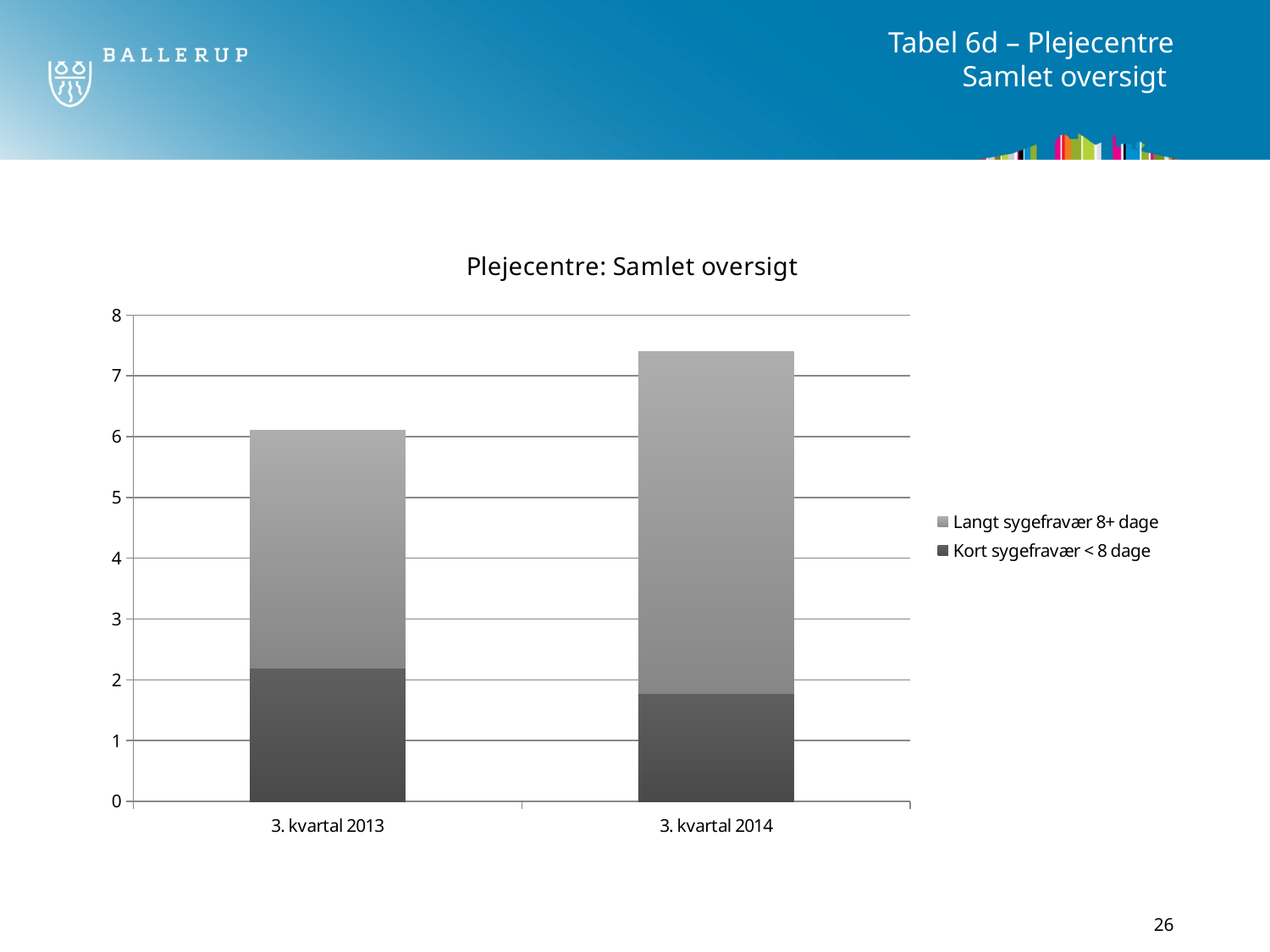
Which quarter has the larger Kort sygefravær < 8 dage segment, 3. kvartal 2013 or 3. kvartal 2014? 3. kvartal 2013 What is the title of the chart? Plejecentre: Samlet oversigt Which quarter has the taller stacked bar in total, 3. kvartal 2013 or 3. kvartal 2014? 3. kvartal 2014 What kind of chart is shown on the slide? Stacked bar chart Which series is shown in the darker grey colour? Kort sygefravær < 8 dage How many categories are shown on the x axis? 2 How many series does the legend list? 2 Is the total height of the stacked bar for 3. kvartal 2013 greater or less than 7? less Is the value of Kort sygefravær < 8 dage for 3. kvartal 2014 greater or less than 2? less Is the Langt sygefravær 8+ dage segment for 3. kvartal 2014 greater or less than 5? greater Does the total stacked bar height rise or fall from 3. kvartal 2013 to 3. kvartal 2014? rise